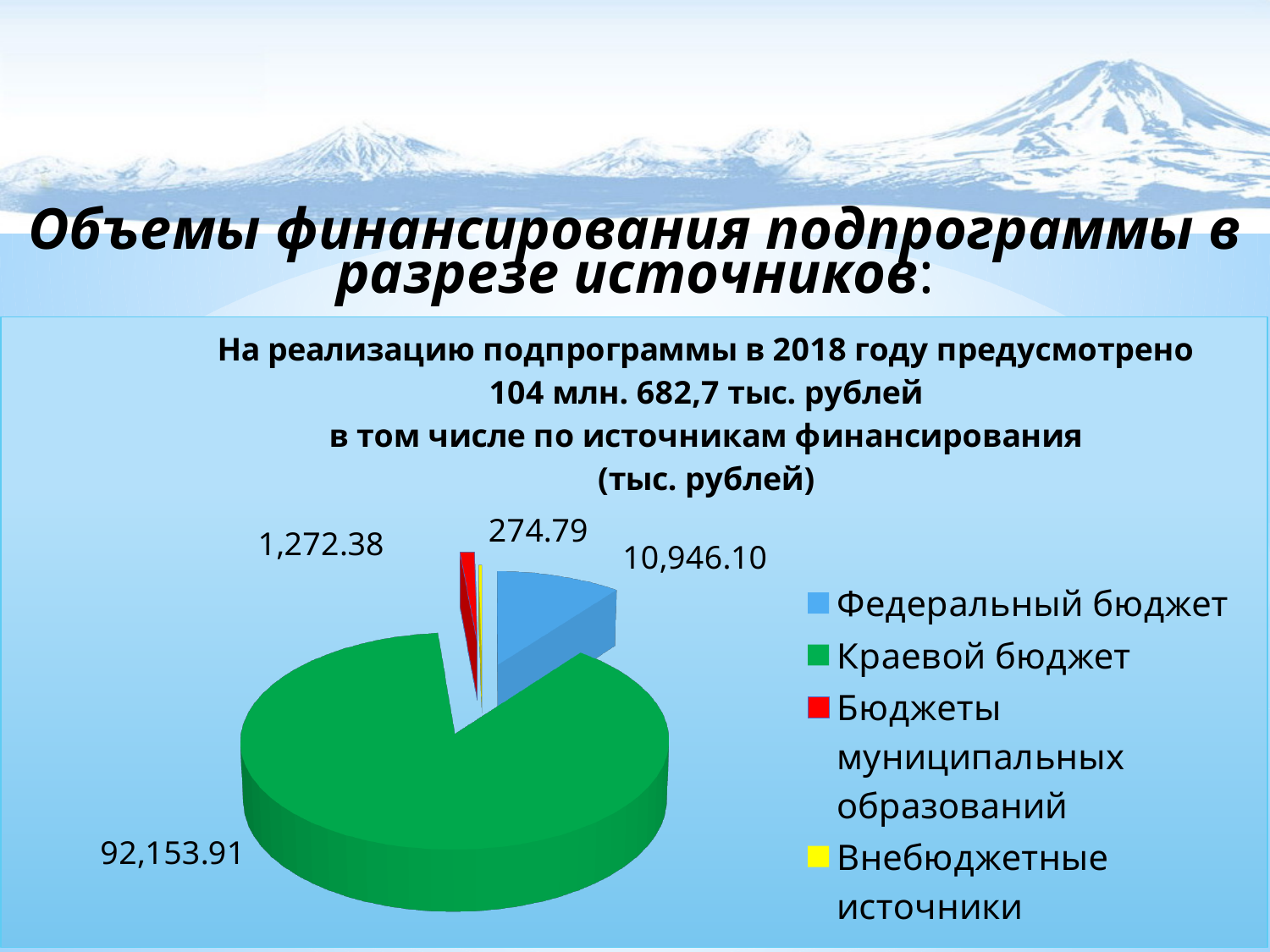
What is the difference between the values for Краевой бюджет and Федеральный бюджет? 81,207.81 Which is larger, the value for Федеральный бюджет or the value for Бюджеты муниципальных образований? Федеральный бюджет What value is shown for Федеральный бюджет? 10,946.10 Which funding source has the smallest slice of the pie? Внебюджетные источники Which funding source has the largest slice of the pie? Краевой бюджет What colour is the slice for Краевой бюджет? Green What is the difference between the values for Бюджеты муниципальных образований and Внебюджетные источники? 997.59 What value is shown for Краевой бюджет? 92,153.91 How many slices does the pie chart have? 4 What value is shown for Внебюджетные источники? 274.79 What type of chart is shown on the slide? Pie chart What value is shown for Бюджеты муниципальных образований? 1,272.38